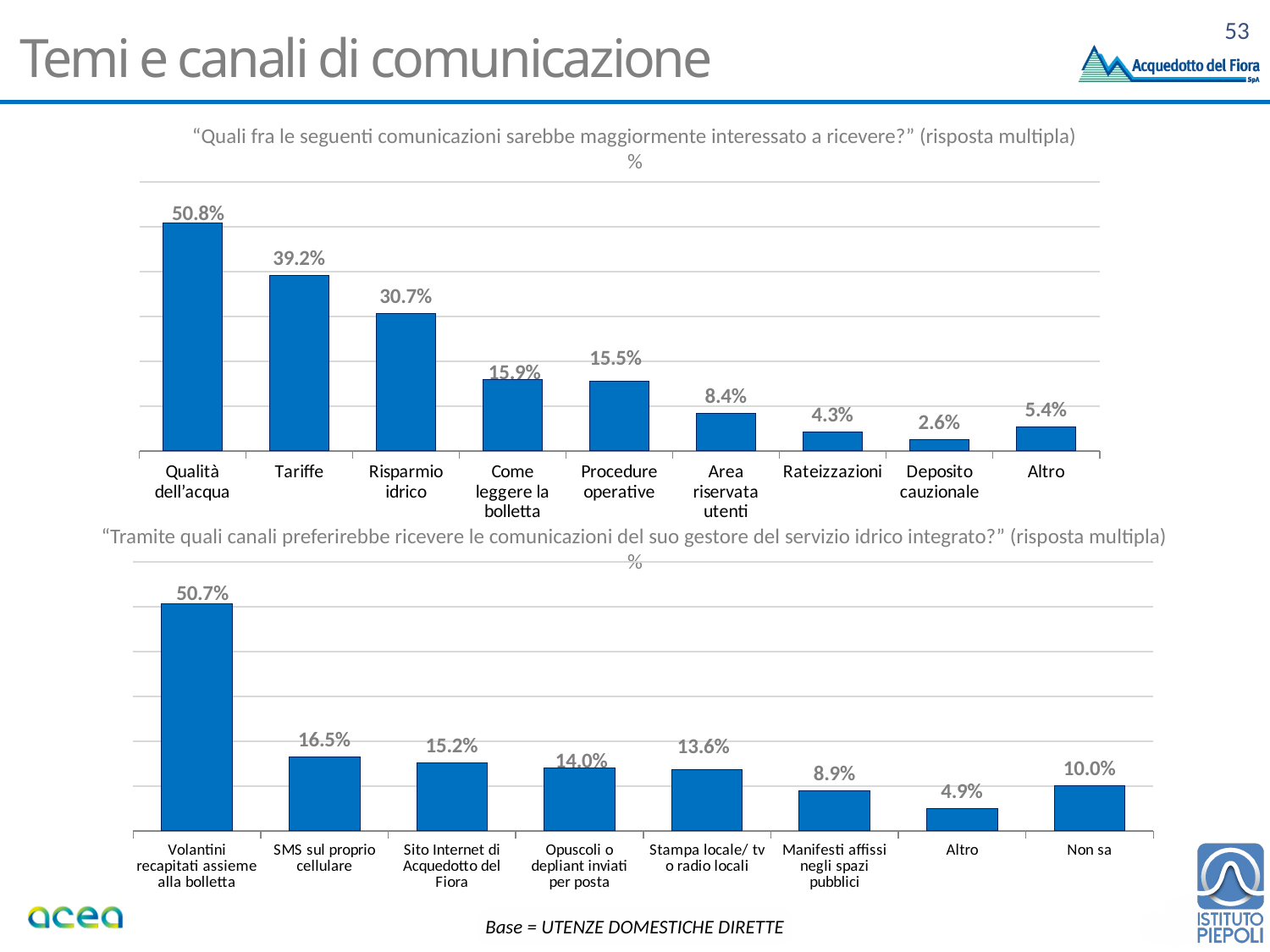
In the top chart, which is larger: Area riservata utenti or Altro? Area riservata utenti In the top chart, what is the difference between Qualità dell'acqua and Risparmio idrico? 20.1% In the top chart, what is the value for Tariffe? 39.2% In the bottom chart, what is the value for SMS sul proprio cellulare? 16.5% In the top chart, which category has the lowest value? Deposito cauzionale In the bottom chart, how many categories are shown? 8 In the bottom chart, which category has the lowest value? Altro In the bottom chart, which category has the highest value? Volantini recapitati assieme alla bolletta In the top chart, which category has the highest value? Qualità dell'acqua In the bottom chart, what is the difference between Sito Internet di Acquedotto del Fiora and Stampa locale/ tv o radio locali? 1.6% In the top chart, how many categories are shown? 9 What type of chart is the bottom chart? Bar chart